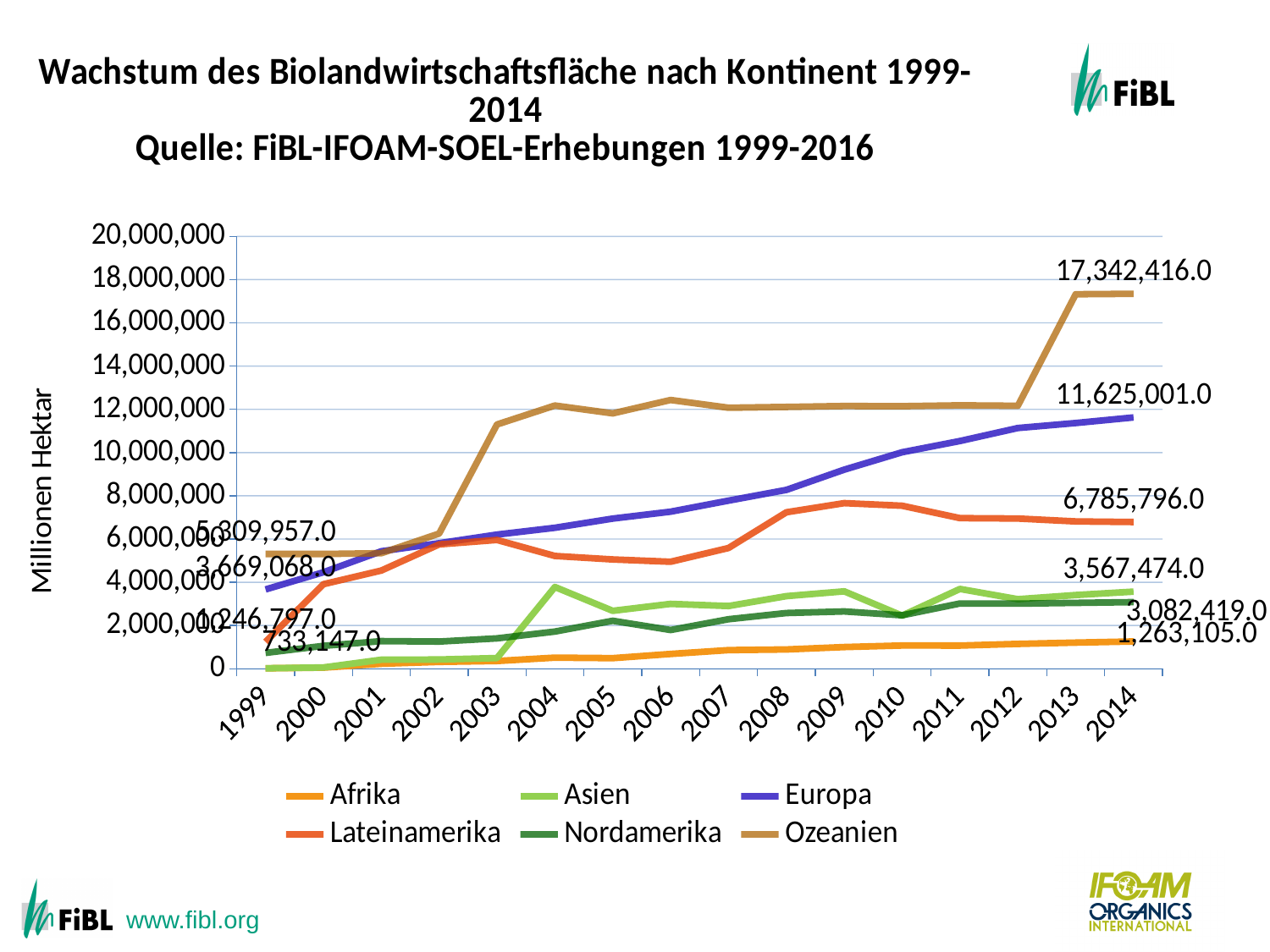
Is the value for Ozeanien in 2003 greater or less than 10,000,000? greater In 2014, which is larger: the value for Asien or the value for Nordamerika? Asien How many series does the legend list? 6 What kind of chart is shown on the slide? line chart What is the value for Europa in 2014? 11,625,001.0 How many years are shown on the x axis? 16 What is the value for Afrika in 2014? 1,263,105.0 What is the difference between the 2014 values for Ozeanien and Europa? 5,717,415.0 What is the value for Lateinamerika in 2014? 6,785,796.0 What is the value for Ozeanien in 2014? 17,342,416.0 Which continent has the highest value in 2014? Ozeanien Which continent has the lowest value in 2014? Afrika